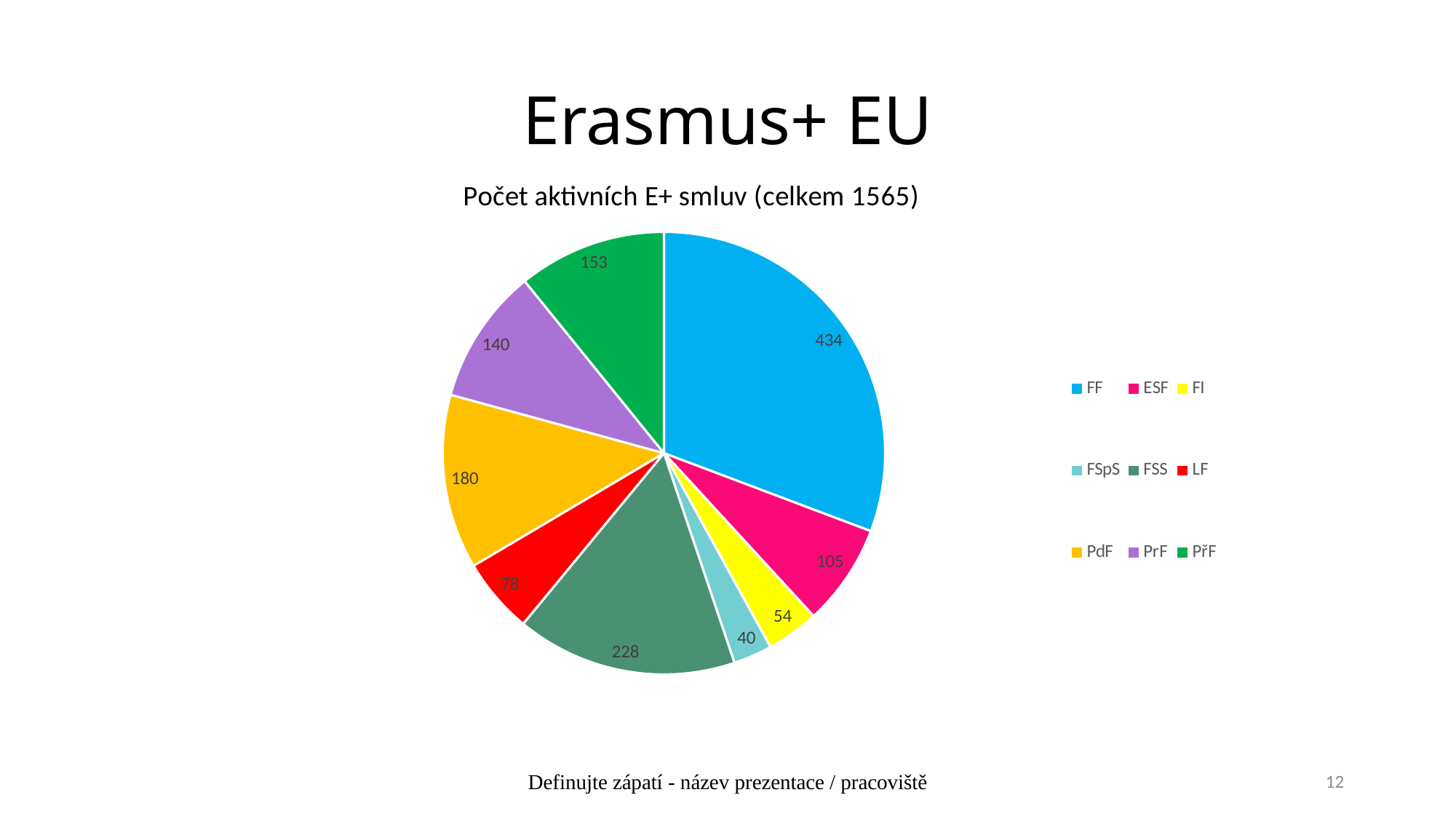
What is the difference between the values for FF and FSS? 206 What is the value for FSS in the pie chart? 228 How many categories does the pie chart show? 9 Which is larger, the value for PřF or the value for PrF? PřF Which category has the smallest slice in the pie chart? FSpS What is the value for PdF in the pie chart? 180 Which category has the largest slice in the pie chart? FF What kind of chart is shown on the slide? pie chart What is the value for FF in the pie chart? 434 What is the difference between the values for PdF and PrF? 40 What is the value for FSpS in the pie chart? 40 What is the title of the chart? Počet aktivních E+ smluv (celkem 1565)